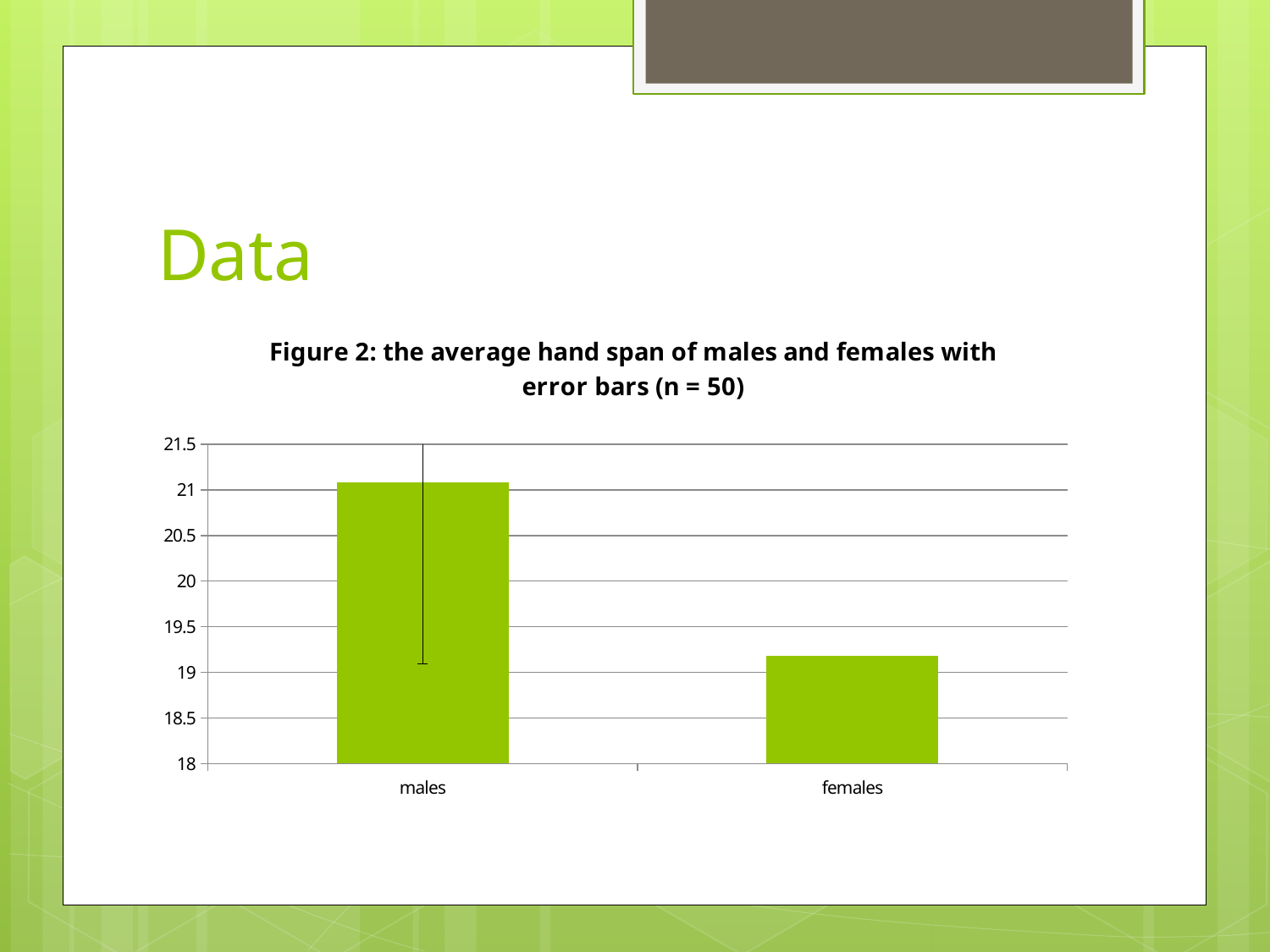
How many categories are plotted in the chart? 2 What is the title of the chart? Figure 2: the average hand span of males and females with error bars (n = 50) What is the lowest value shown on the vertical axis? 18 Which category's bar has an error bar drawn on it? males What kind of chart is shown on the slide? bar chart Is the value for males greater or less than 20? greater Is the value for females greater or less than 20? less Which category has the highest average hand span? males Which is larger, the value for males or the value for females? males Is the value for males greater or less than 20.5? greater Which category has the lowest average hand span? females